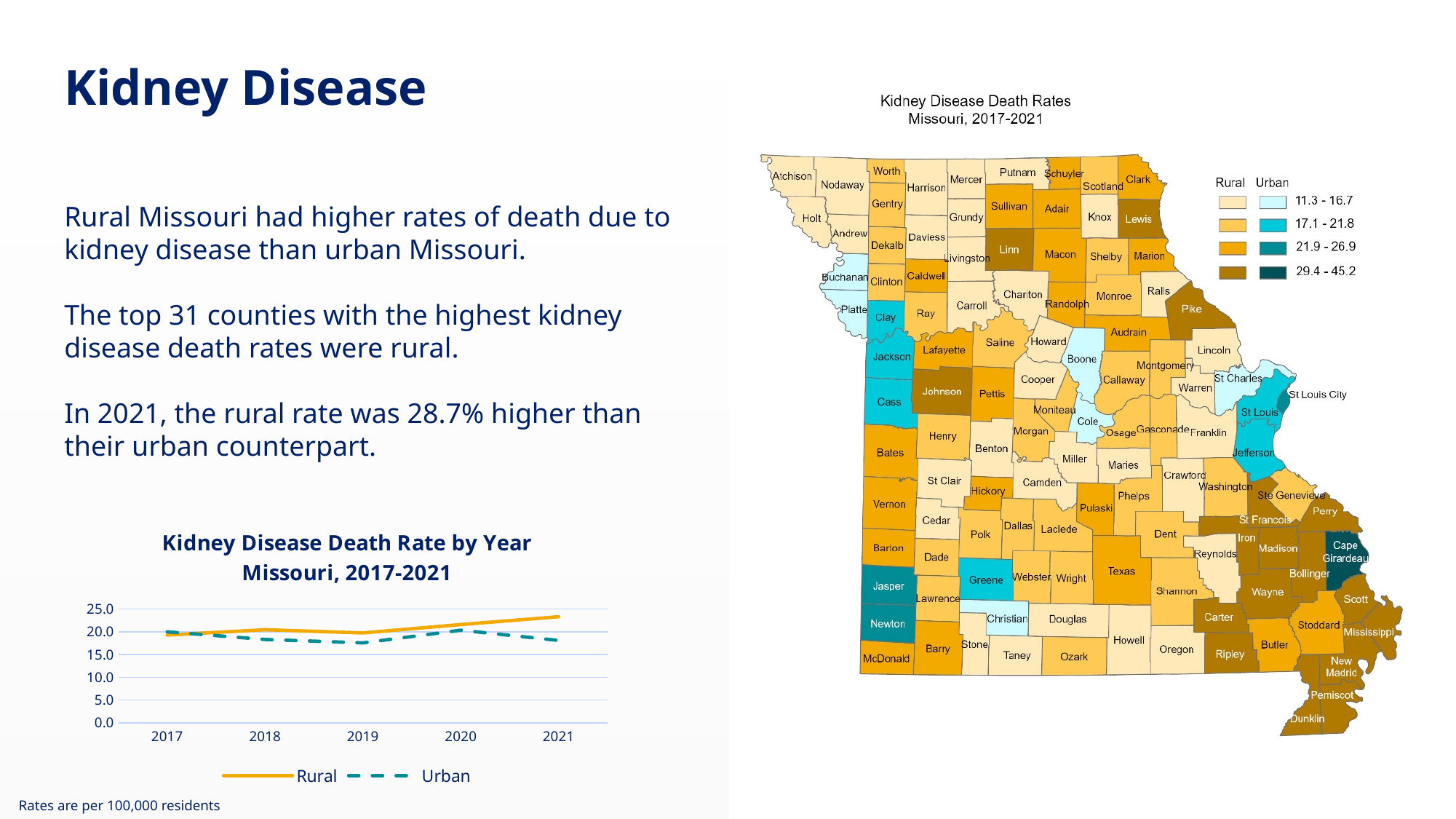
In the map legend, what is the highest death rate range shown? 29.4 - 45.2 In the 'Kidney Disease Death Rate by Year' chart, does the Rural line rise or fall from 2019 to 2021? rise In the 'Kidney Disease Death Rate by Year' chart, is the Urban value for 2019 greater or less than 20.0? less How many series does the legend of the 'Kidney Disease Death Rate by Year' chart list? 2 In the 'Kidney Disease Death Rate by Year' chart, is the Rural value for 2021 greater or less than 20.0? greater In the 'Kidney Disease Death Rate by Year' chart, which year has the highest Rural value? 2021 In the 'Kidney Disease Death Rate by Year' chart, which series is drawn with a dashed line? Urban In the 'Kidney Disease Death Rate by Year' chart, is the Rural value for 2021 greater or less than 25.0? less In the 'Kidney Disease Death Rate by Year' chart, which series has the higher value in 2021, Rural or Urban? Rural What kind of chart is the 'Kidney Disease Death Rate by Year' chart? line chart What is the title of the map on the right side of the slide? Kidney Disease Death Rates Missouri, 2017-2021 How many years are plotted on the x axis of the 'Kidney Disease Death Rate by Year' chart? 5